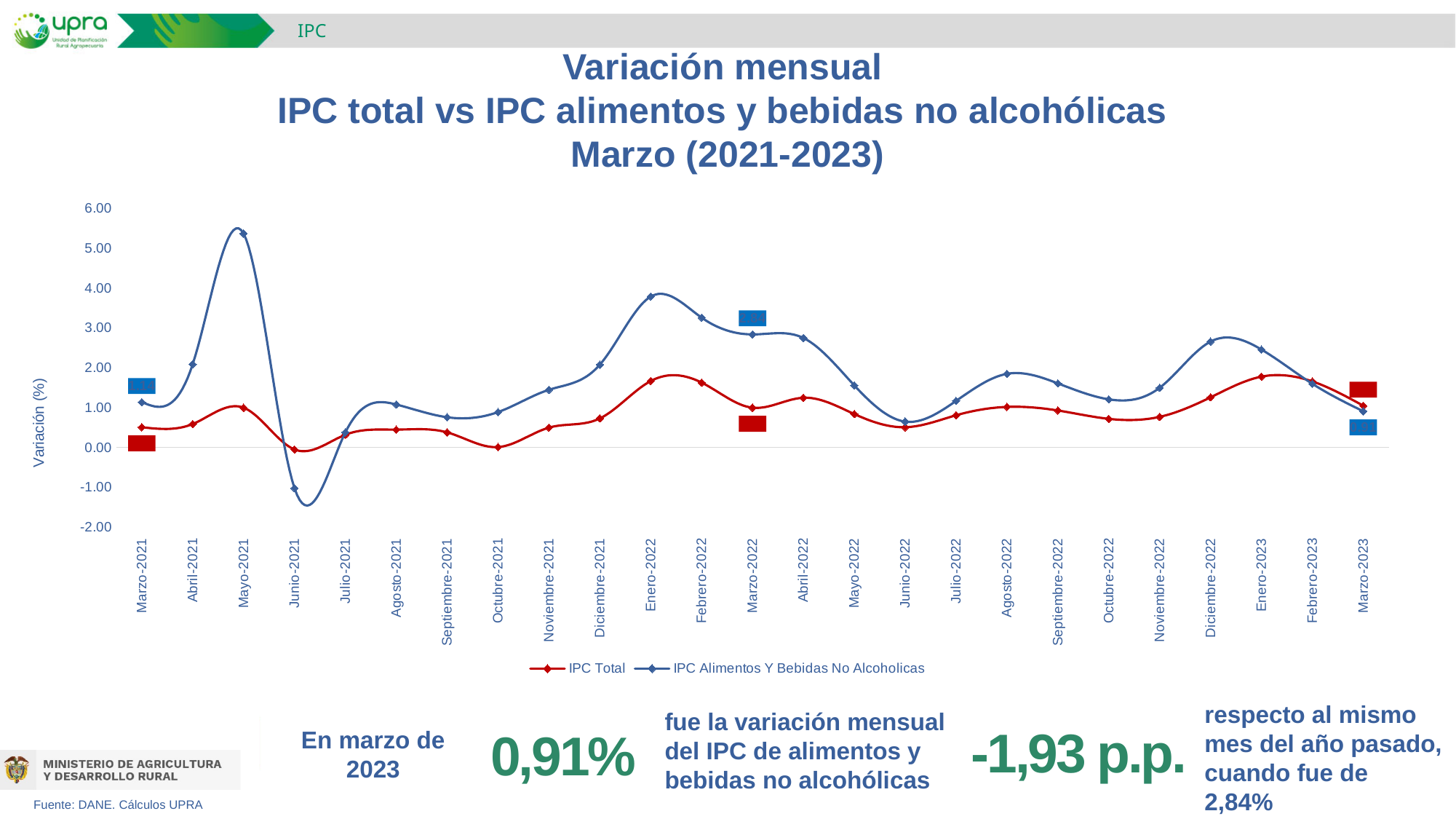
In which month does the IPC Alimentos Y Bebidas No Alcoholicas series reach its highest value? Mayo-2021 Is the value for IPC Alimentos Y Bebidas No Alcoholicas in Enero-2022 greater or less than 3.00? greater What is the label on the vertical axis of the chart? Variación (%) In Mayo-2021, which series has the larger value, IPC Total or IPC Alimentos Y Bebidas No Alcoholicas? IPC Alimentos Y Bebidas No Alcoholicas Is the value for IPC Alimentos Y Bebidas No Alcoholicas in Mayo-2021 greater or less than 5.00? greater What kind of chart is shown on the slide? line chart How many series does the legend list? 2 According to the slide, what was the monthly variation of the IPC de alimentos y bebidas no alcohólicas in March 2023? 0,91% How many months are plotted along the x axis? 25 In which month does the IPC Alimentos Y Bebidas No Alcoholicas series reach its lowest value? Junio-2021 Does the IPC Alimentos Y Bebidas No Alcoholicas series rise or fall from Marzo-2021 to Mayo-2021? rise